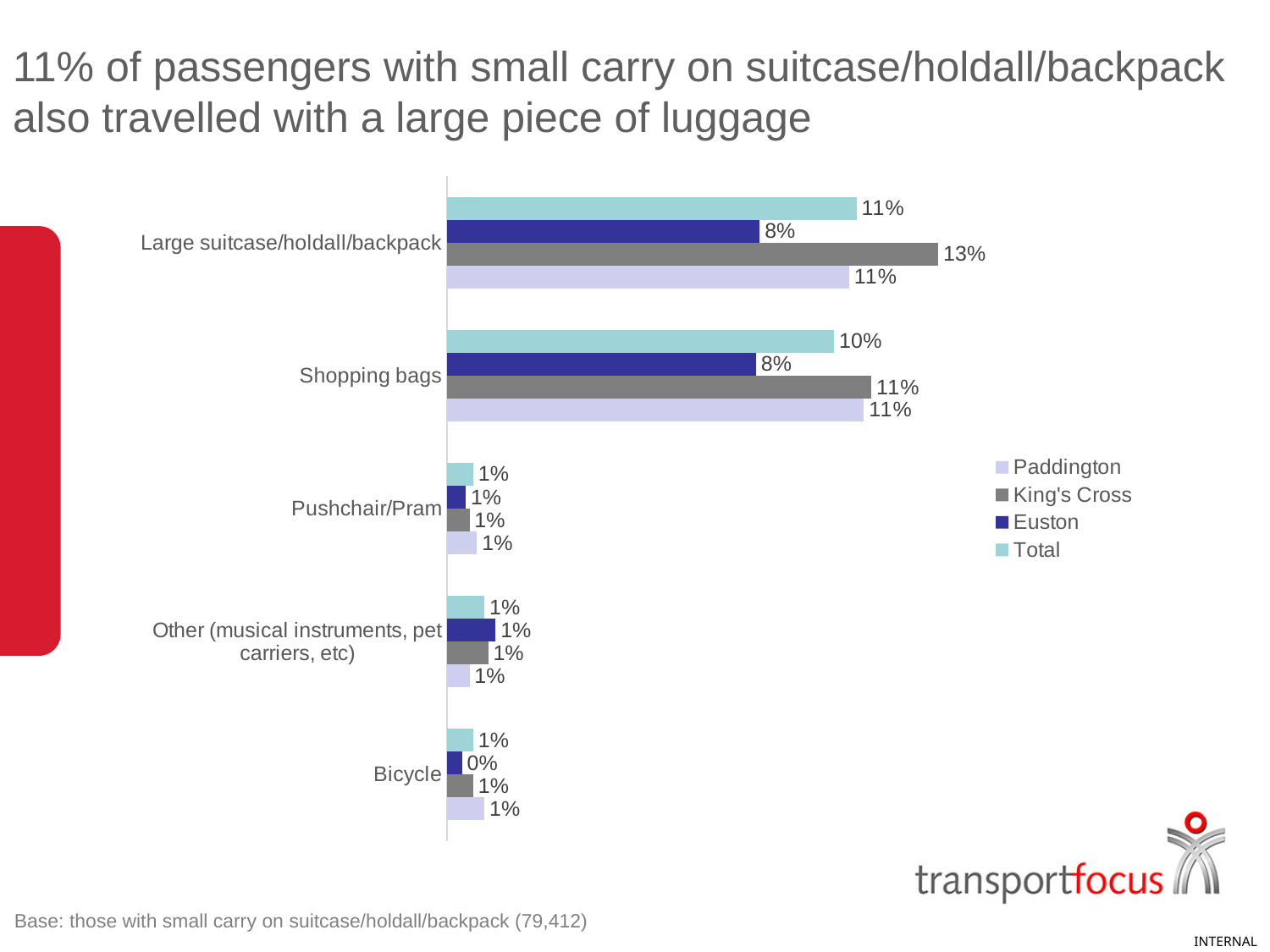
What is the difference between the King's Cross and Euston values for Large suitcase/holdall/backpack? 5% What is the Total value for Shopping bags? 10% Which station has the highest value for Large suitcase/holdall/backpack? King's Cross Which legend entry is shown in dark blue? Euston For Shopping bags, is the King's Cross value larger or smaller than the Total value? larger What is the King's Cross value for Large suitcase/holdall/backpack? 13% What kind of chart is shown on the slide? bar chart How many series does the legend list? 4 What is the Euston value for Shopping bags? 8% How many luggage categories are shown on the chart? 5 What is the Euston value for Bicycle? 0% Which station has the lowest value for Shopping bags? Euston